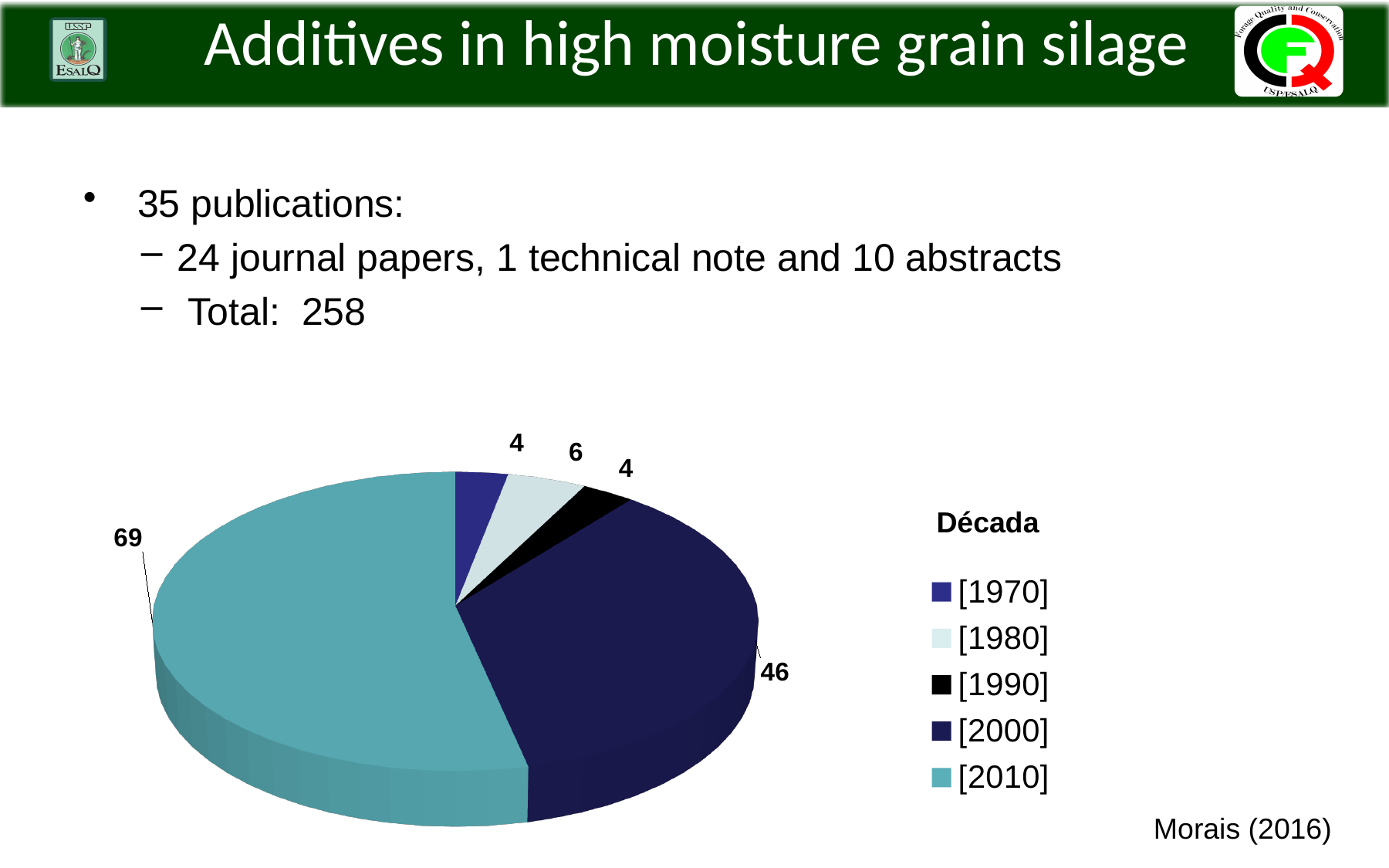
What is the value for the [1970] slice of the pie chart? 4 What is the value for the [1980] slice of the pie chart? 6 What is the difference between the values for [2010] and [2000]? 23 What is the value for the [2010] slice of the pie chart? 69 Which is larger, the value for [1980] or the value for [1990]? [1980] How many slices does the pie chart have? 5 What is the title of the legend next to the pie chart? Década Which decades share the smallest value in the pie chart? [1970] and [1990] What type of chart is shown on the slide? pie chart Which decade has the largest slice in the pie chart? [2010] What is the value for the [2000] slice of the pie chart? 46 What is the sum of all the values shown on the pie chart? 129